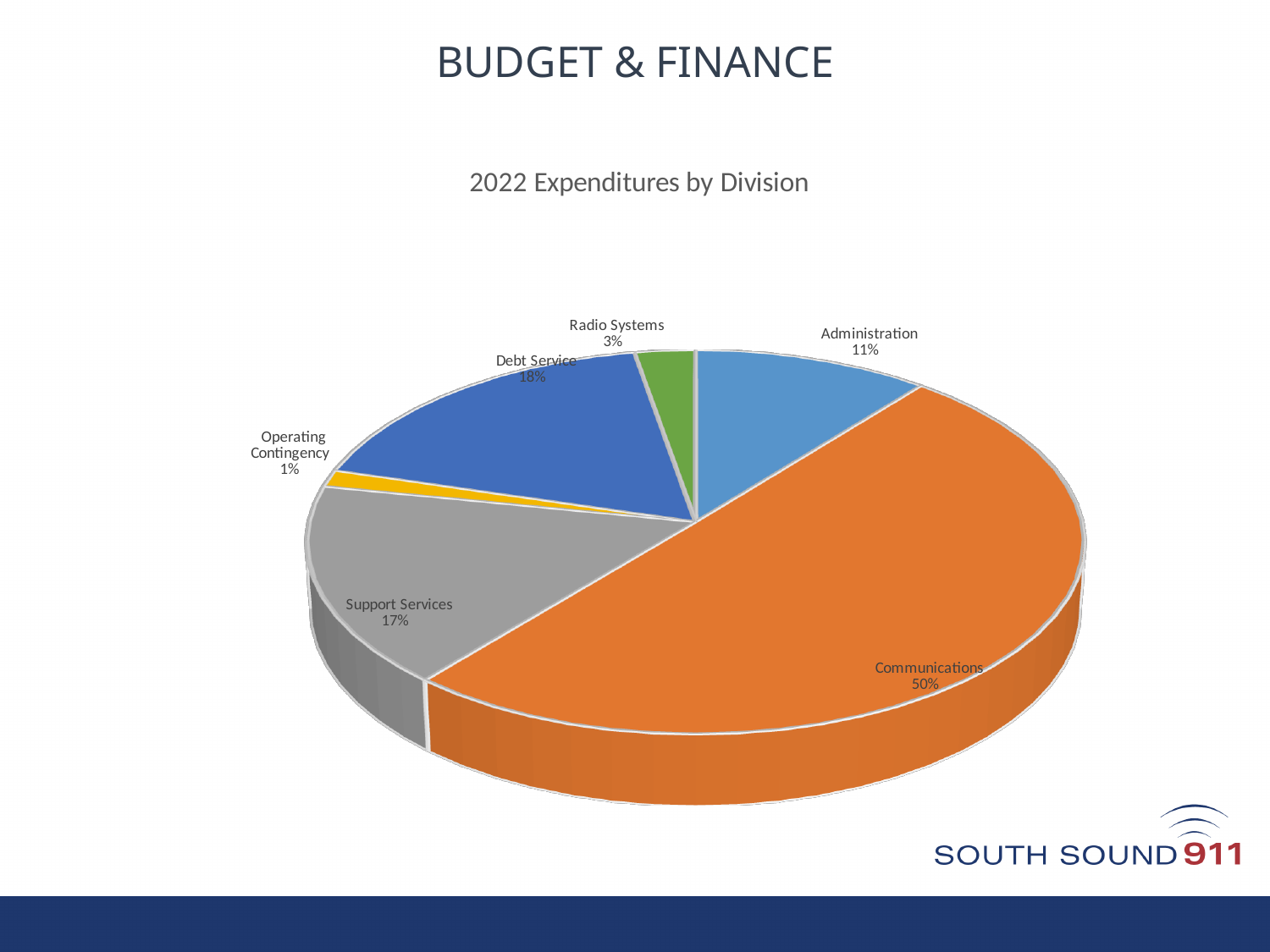
What is the difference in percentage points between Communications and Debt Service? 32 Which division has the largest share of 2022 expenditures? Communications What share of 2022 expenditures goes to Debt Service? 18% Which has a larger share, Administration or Support Services? Support Services What share of 2022 expenditures goes to Radio Systems? 3% What is the title of the chart? 2022 Expenditures by Division What share of 2022 expenditures goes to Administration? 11% What type of chart is shown on the slide? Pie chart What share of 2022 expenditures goes to Communications? 50% What share of 2022 expenditures goes to Support Services? 17% Which division has the smallest share of 2022 expenditures? Operating Contingency How many divisions are shown in the pie chart? 6